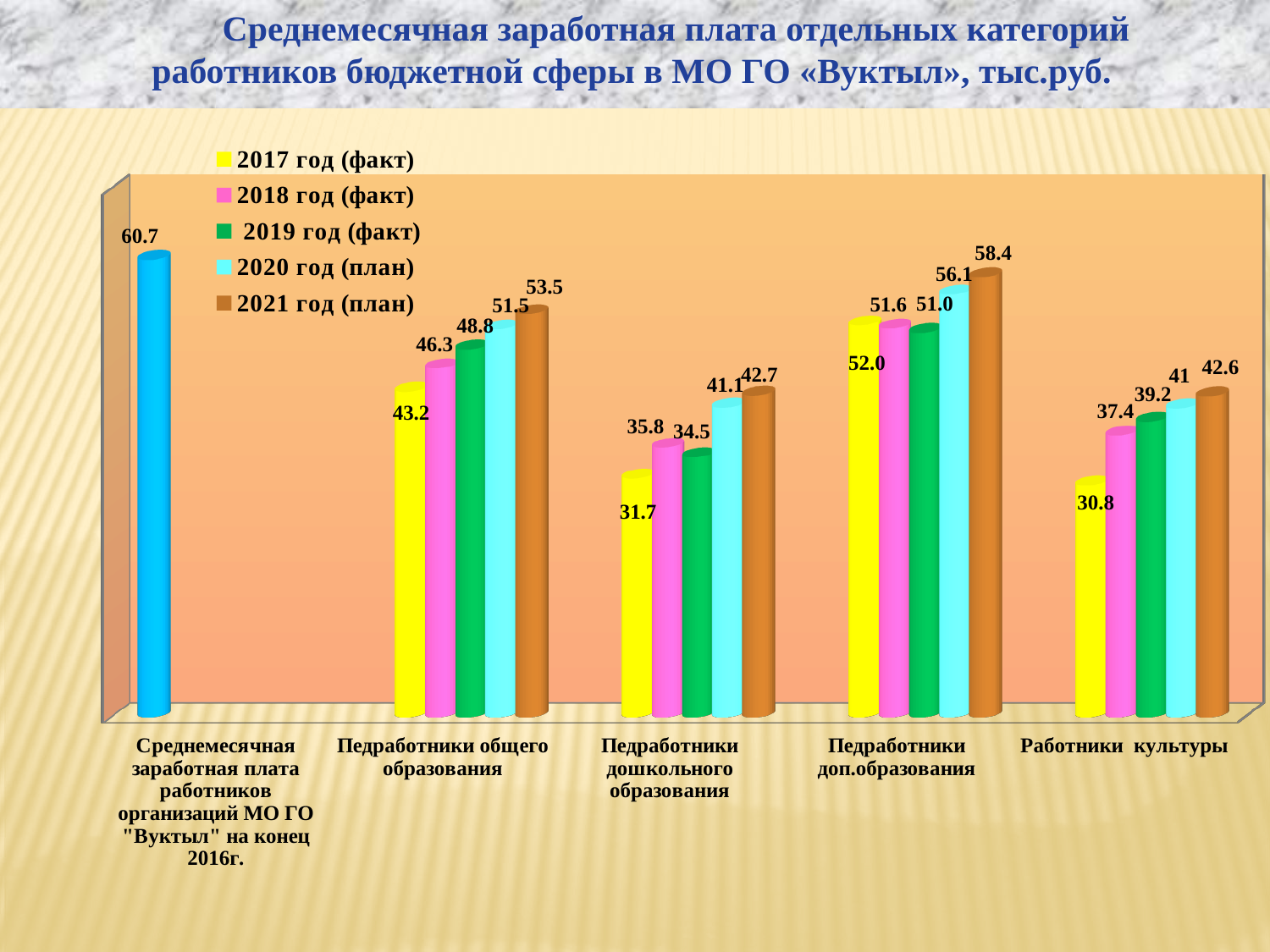
Among the 2021 год (план) bars, which category has the highest value? Педработники доп.образования How many series does the legend list? 5 What is the difference between the 2021 год (план) and 2017 год (факт) values for Педработники общего образования? 10.3 What kind of chart is shown on the slide? Bar chart What is the 2021 год (план) value for Педработники доп.образования? 58.4 What is the 2019 год (факт) value for Работники культуры? 39.2 What is the 2017 год (факт) value for Педработники общего образования? 43.2 Do the values for Работники культуры rise or fall from 2017 год (факт) to 2021 год (план)? Rise Which is larger for Педработники дошкольного образования: the 2018 год (факт) value or the 2019 год (факт) value? 2018 год (факт) What is the 2020 год (план) value for Педработники дошкольного образования? 41.1 How many categories are shown on the x axis? 5 Which category has the lowest 2017 год (факт) value? Работники культуры